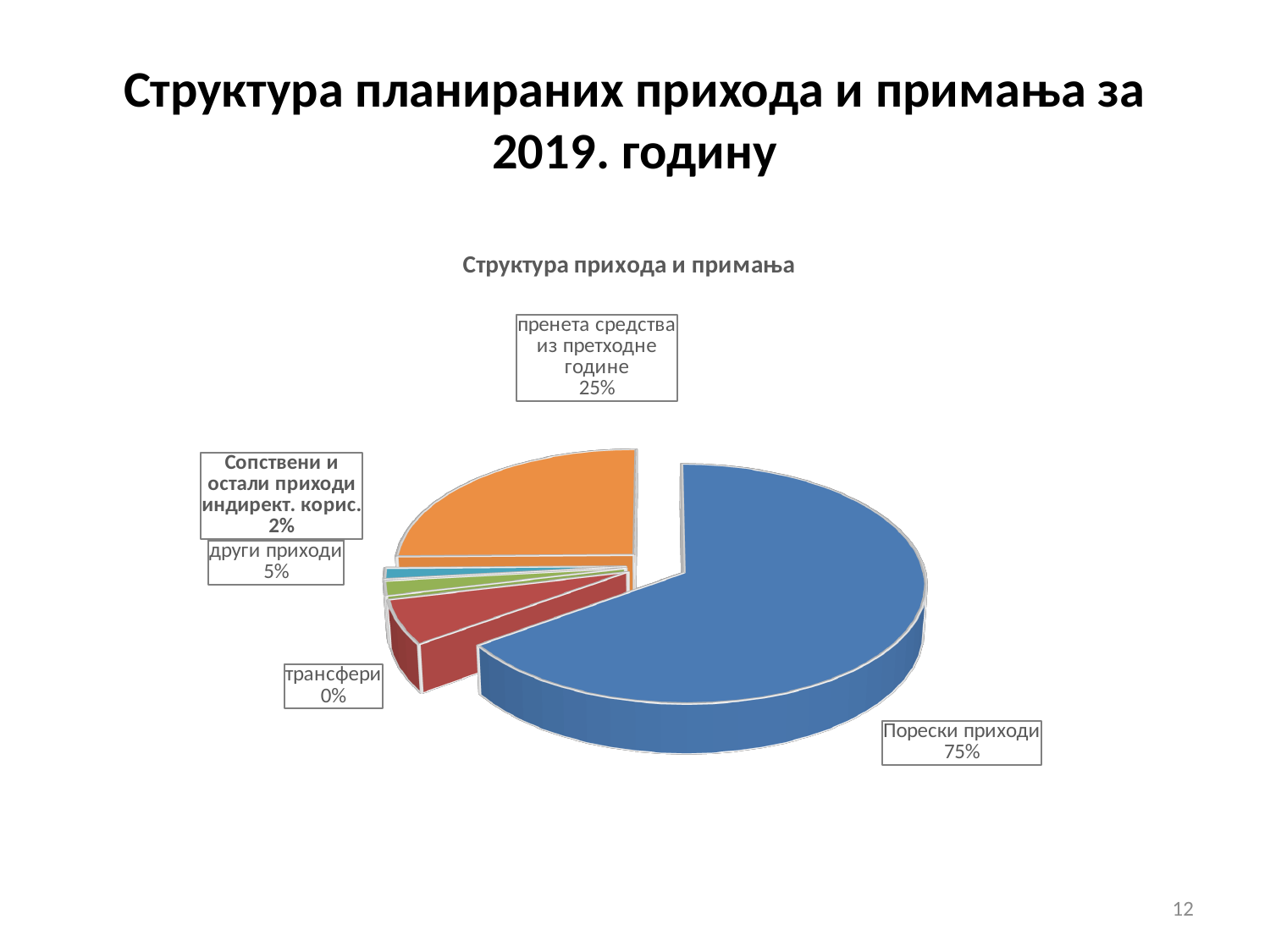
What share of the pie is Сопствени и остали приходи индирект. корис.? 2% How many categories (slices) does the pie chart show? 5 Which category has the smallest share of the pie? трансфери What share of the pie is пренета средства из претходне године? 25% What is the chart's title? Структура прихода и примања What is the difference in percentage points between Порески приходи and пренета средства из претходне године? 50 percentage points Which category has the largest share of the pie? Порески приходи What share of the pie is трансфери? 0% What kind of chart is shown on the slide? pie chart Which is larger, the share for други приходи or the share for Сопствени и остали приходи индирект. корис.? други приходи What share of the pie is Порески приходи? 75% What share of the pie is други приходи? 5%